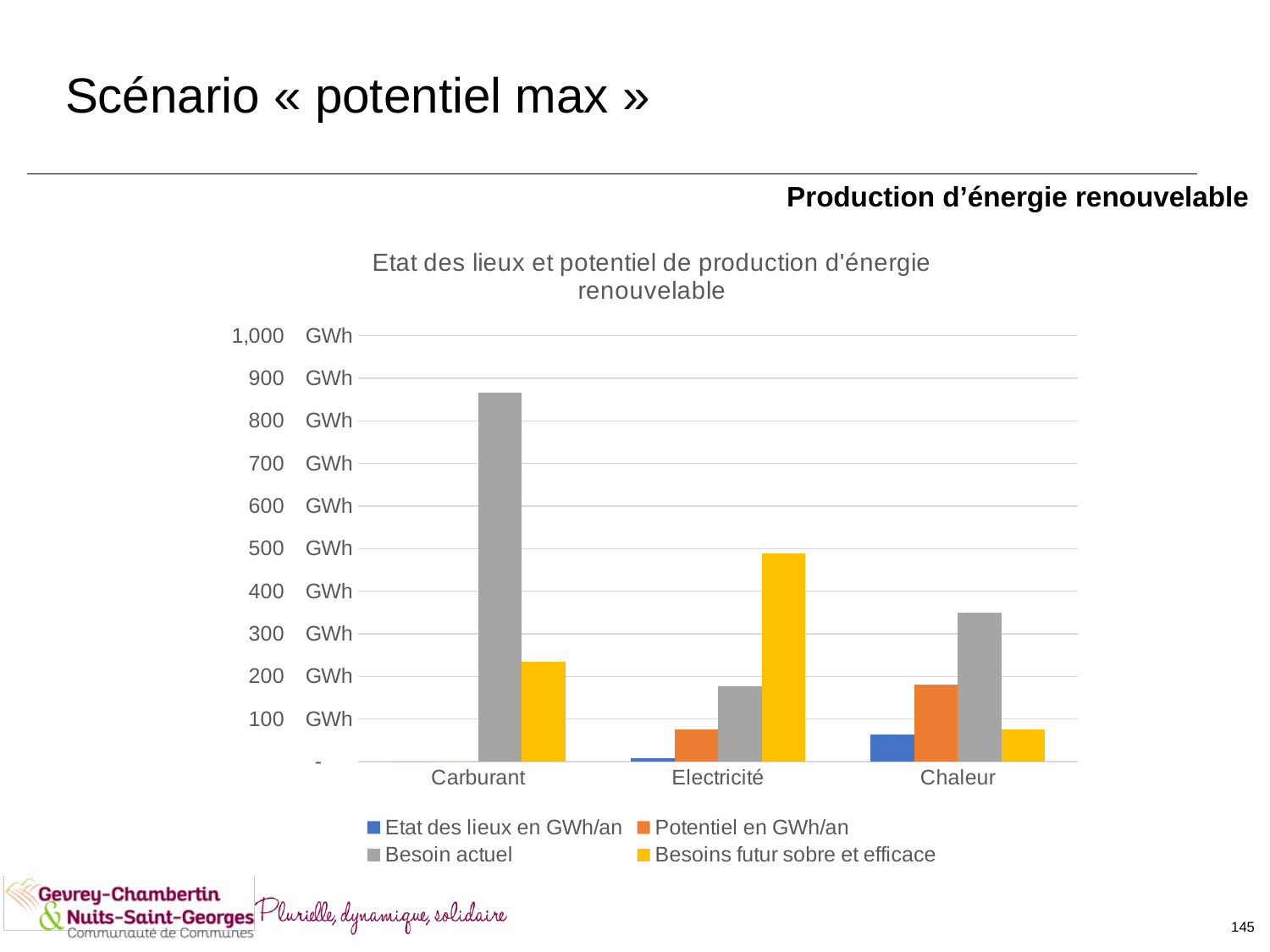
Which category has the highest value for the 'Besoin actuel' series? Carburant What kind of chart is shown on the slide? bar chart Is the 'Besoin actuel' value for Chaleur greater or less than 300 GWh? greater Which is larger: the 'Besoin actuel' value for Chaleur or for Electricité? Chaleur How many categories are shown on the x axis of the chart? 3 Is the 'Potentiel en GWh/an' value for Chaleur greater or less than 100 GWh? greater Is the 'Besoin actuel' value for Carburant greater or less than 800 GWh? greater Which category has the highest value for the 'Besoins futur sobre et efficace' series? Electricité How many series does the chart's legend list? 4 What is the title of the chart? Etat des lieux et potentiel de production d'énergie renouvelable Which is larger: the 'Potentiel en GWh/an' value for Chaleur or for Electricité? Chaleur